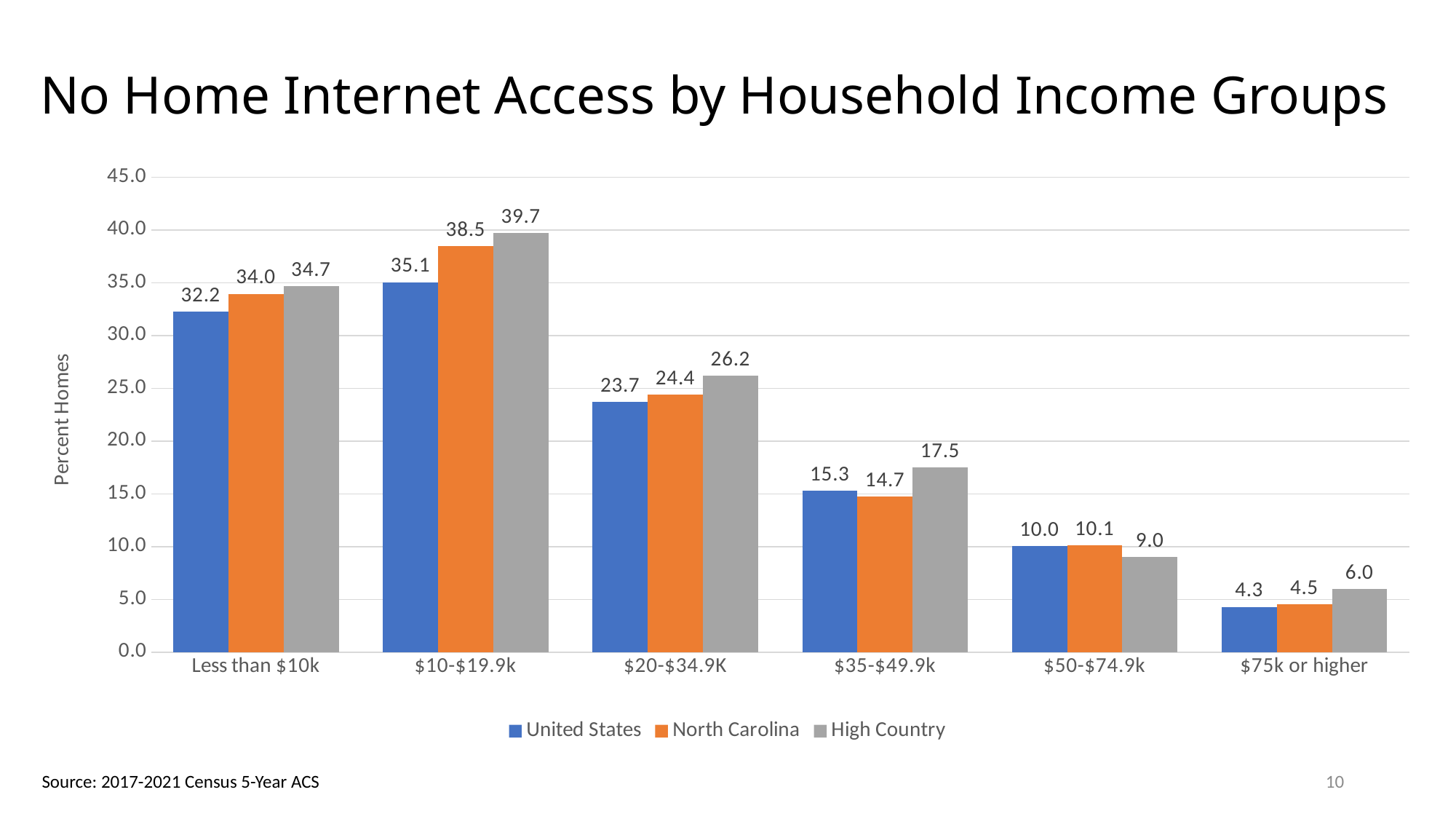
How many series does the legend list? 3 Which income group has the highest value for North Carolina? $10-$19.9k What is the value for North Carolina in the $75k or higher income group? 4.5 From the $10-$19.9k group to the $75k or higher group, do the High Country values rise or fall? Fall What is the value for High Country in the $10-$19.9k income group? 39.7 In the $50-$74.9k income group, which is larger: the United States value or the High Country value? United States What is the value for United States in the $35-$49.9k income group? 15.3 What is the difference between the High Country and United States values in the $20-$34.9K income group? 2.5 Which income group has the lowest value for High Country? $75k or higher How many income groups are shown on the x axis? 6 What kind of chart is shown on the slide? Bar chart What is the label of the y axis? Percent Homes